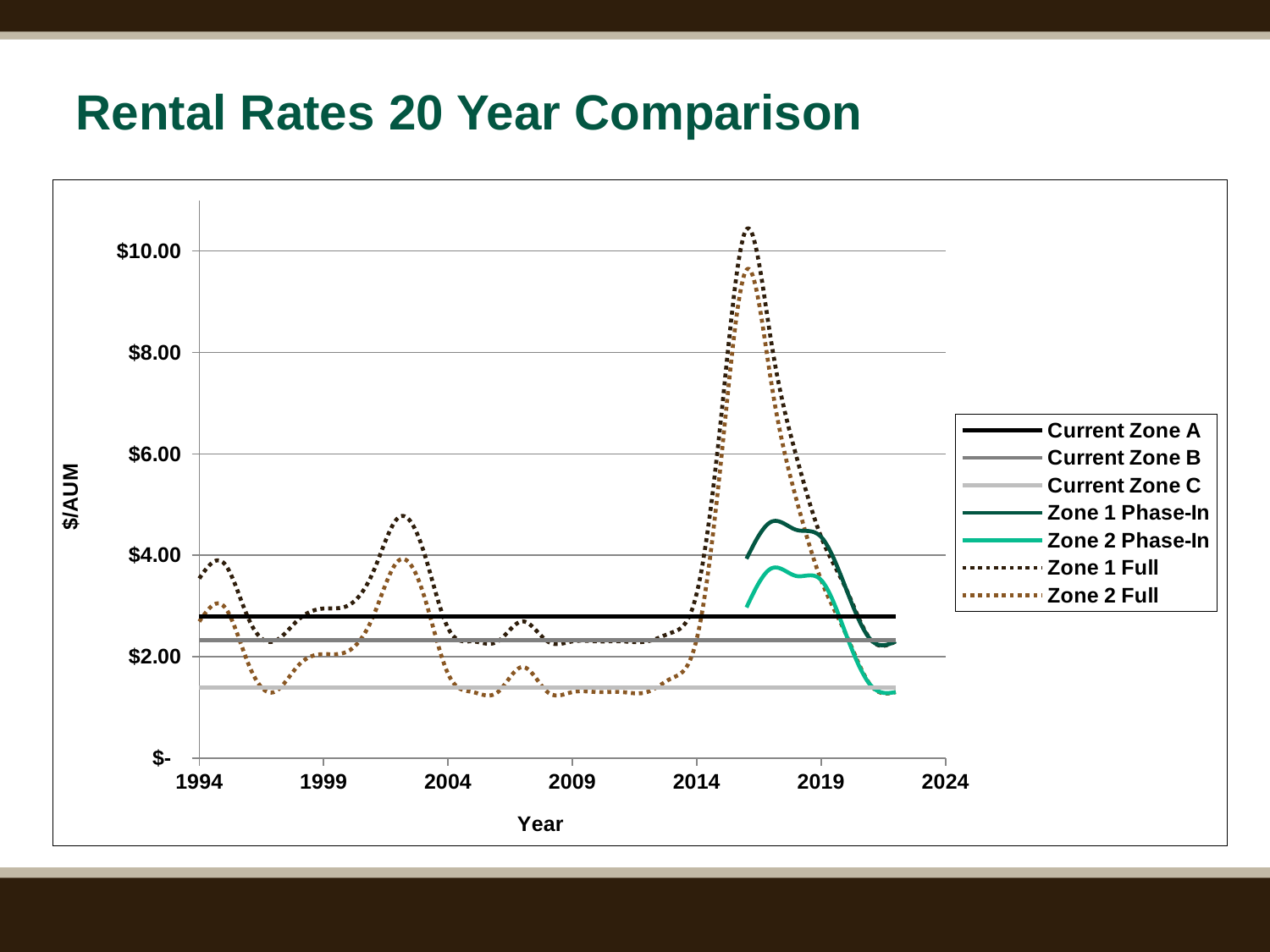
What is the title of the chart? Rental Rates 20 Year Comparison Is the peak value of the Zone 1 Full series greater or less than $10.00? greater Does the Zone 1 Phase-In series rise or fall between 2018 and 2022? fall Around 2017, which is higher, Zone 1 Phase-In or Zone 2 Phase-In? Zone 1 Phase-In Which series reaches the highest value on the chart? Zone 1 Full How many series does the legend list? 7 Is the value of the Current Zone A line greater or less than $2.00? greater What kind of chart is shown on the slide? line chart Which line is higher, Current Zone A or Current Zone C? Current Zone A Is the peak value of the Zone 2 Full series greater or less than $8.00? greater What is the label on the vertical axis? $/AUM